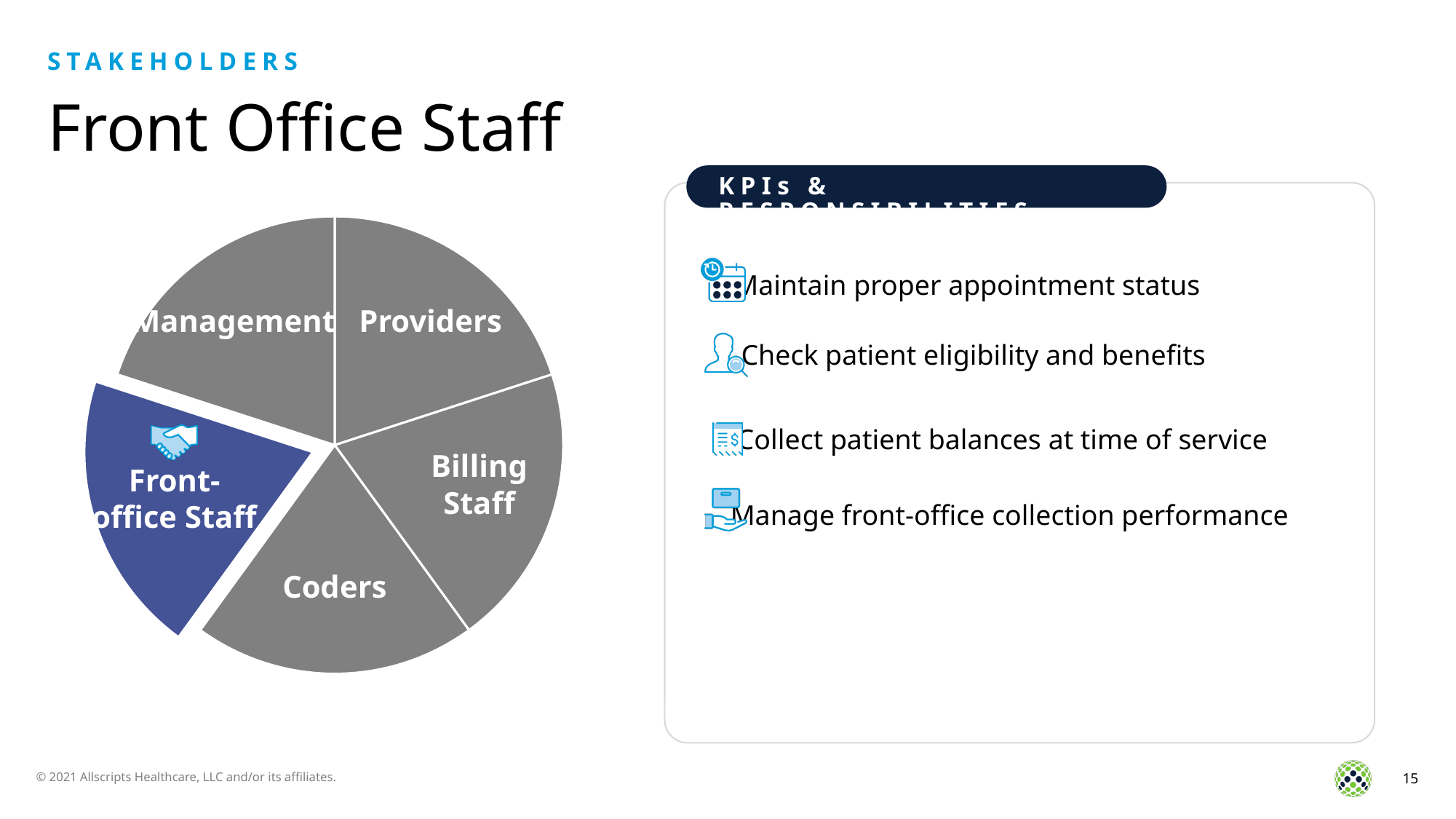
What kind of chart is shown on the slide? Pie chart Which slice of the pie chart sits between the Providers slice and the Coders slice? Billing Staff How many slices does the pie chart have? 5 Which slice of the pie chart is pulled out from the rest of the pie? Front-office Staff Which slice of the pie chart is coloured blue rather than grey? Front-office Staff Which slice of the pie chart is labelled directly to the left of the Providers slice? Management